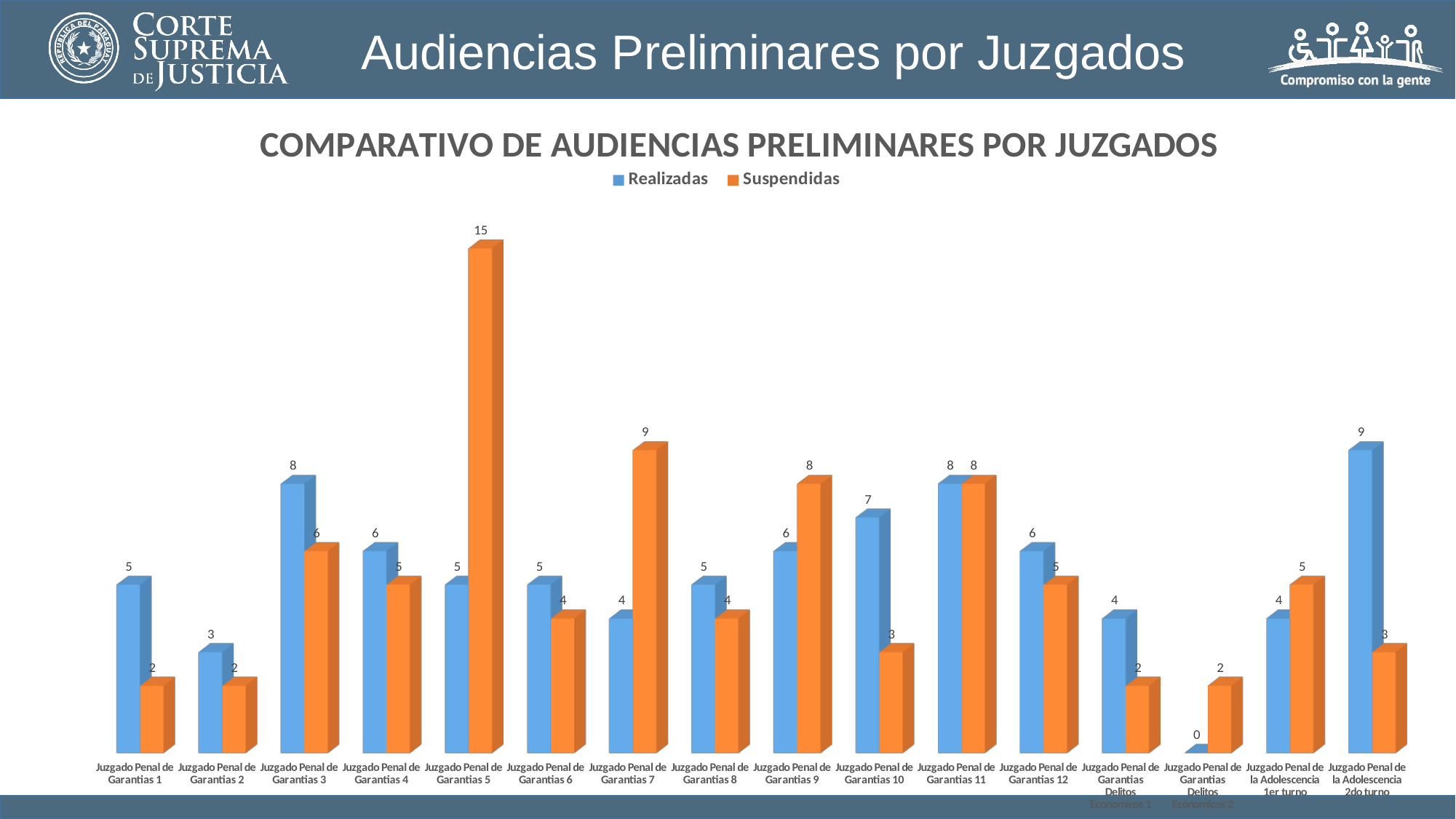
What is the Suspendidas value for Juzgado Penal de Garantias 7? 9 What is the Realizadas value for Juzgado Penal de Garantias 10? 7 For Juzgado Penal de Garantias 9, which is larger, Realizadas or Suspendidas? Suspendidas What is the difference between Realizadas and Suspendidas for Juzgado Penal de Garantias 3? 2 Which juzgado has the highest Realizadas value? Juzgado Penal de la Adolescencia 2do turno What is the difference between Suspendidas and Realizadas for Juzgado Penal de Garantias 5? 10 How many juzgados (categories) are shown on the x axis? 16 What kind of chart is shown on the slide? Bar chart Which juzgado has the lowest Realizadas value? Juzgado Penal de Garantias Delitos Economicos 2 Which juzgado has the highest Suspendidas value? Juzgado Penal de Garantias 5 How many series does the legend list? 2 How many Realizadas audiencias are shown for Juzgado Penal de Garantias 5? 5